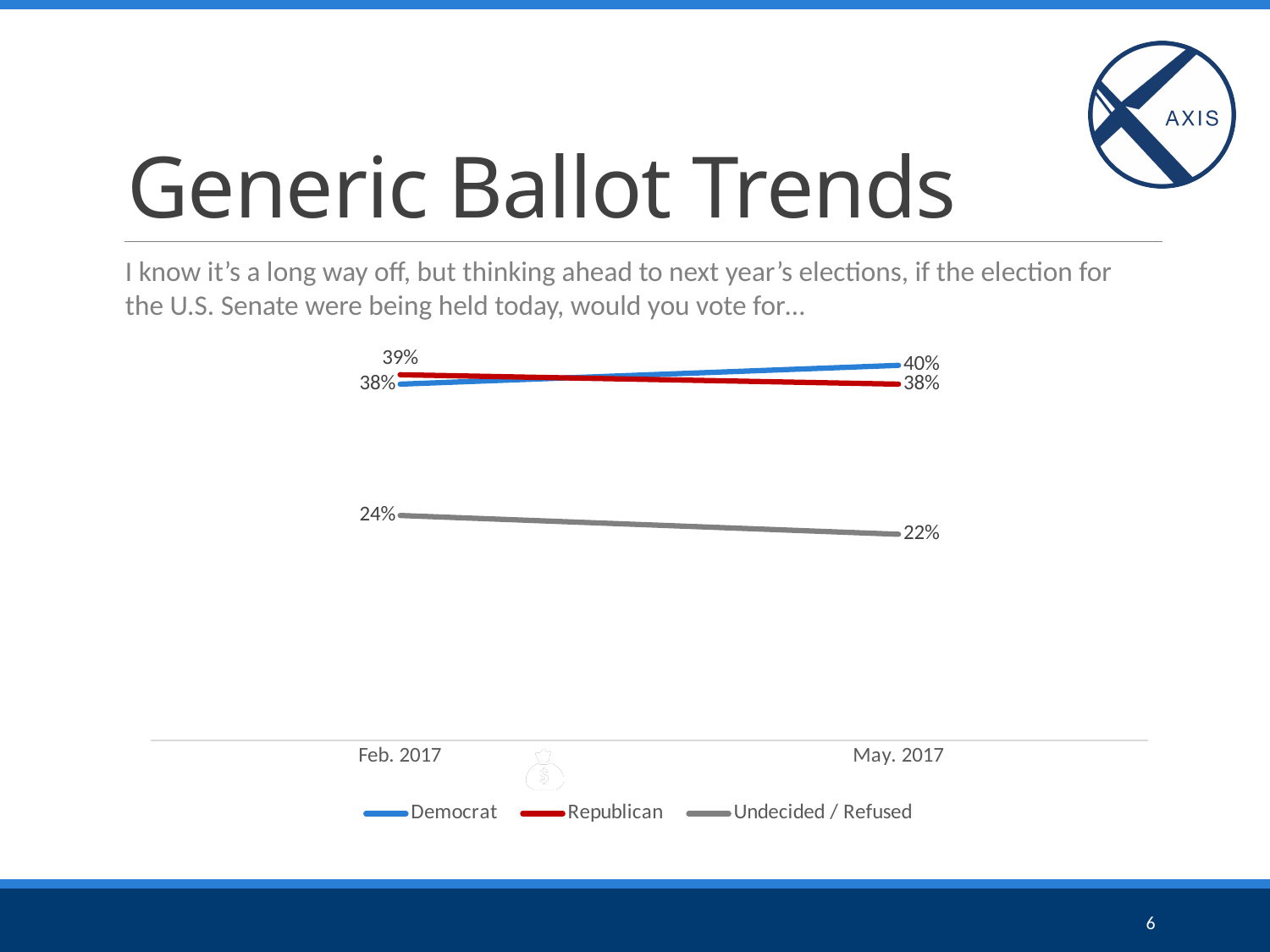
What kind of chart is shown on the slide? Line chart How many series does the legend list? 3 What is the difference between the Democrat and Republican values in May. 2017? 2% Did the Democrat value rise or fall from Feb. 2017 to May. 2017? Rise Which series had the lowest value in May. 2017? Undecided / Refused How many time points are plotted on the x axis? 2 What was the Republican value in May. 2017? 38% What was the Democrat value in May. 2017? 40% Did the Undecided / Refused value rise or fall from Feb. 2017 to May. 2017? Fall What was the Undecided / Refused value in Feb. 2017? 24% What was the Democrat value in Feb. 2017? 38% Which series had the highest value in May. 2017? Democrat